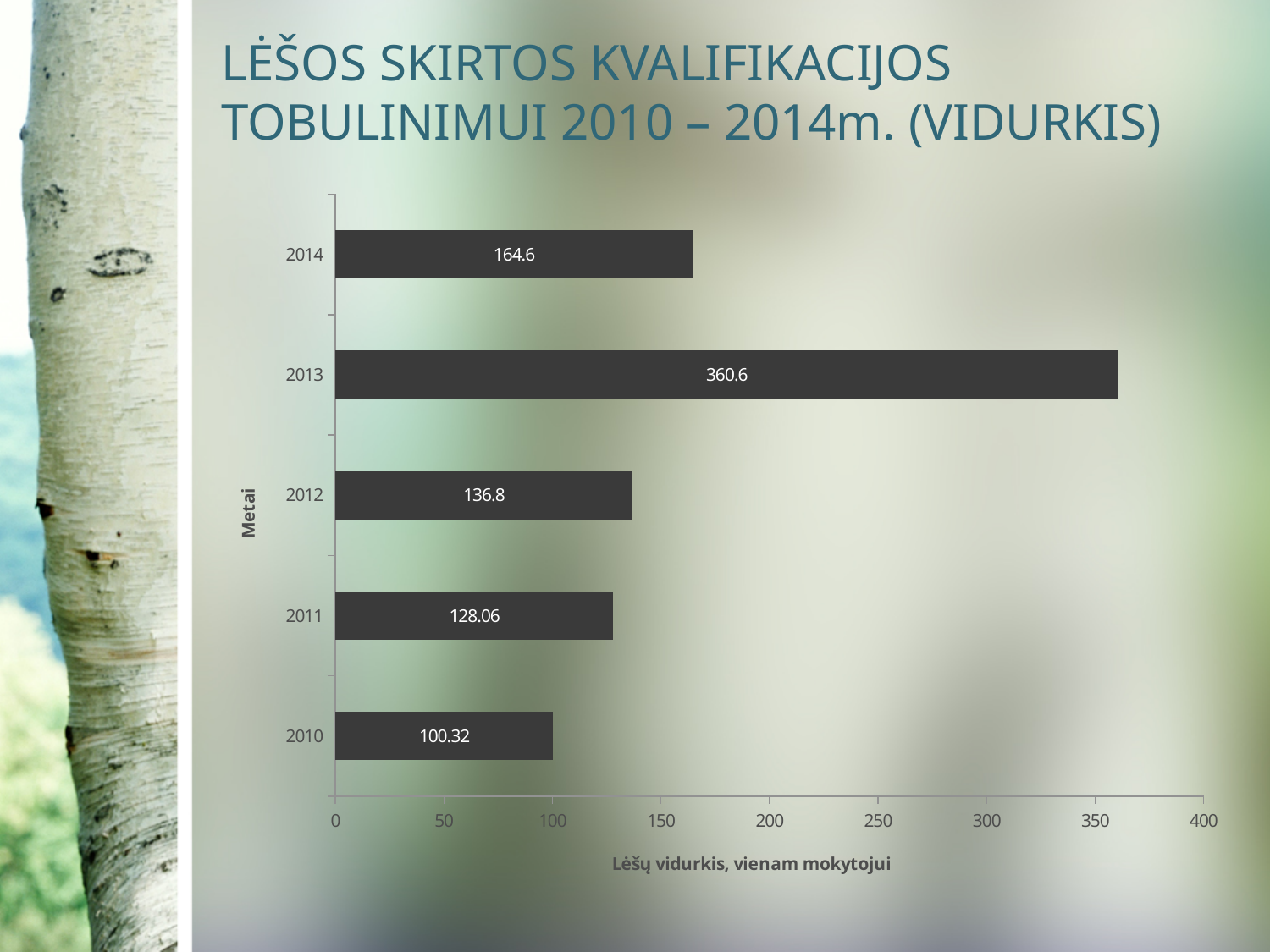
Which year has the lowest value? 2010 What is the difference between the values for 2013 and 2014? 196 What is the value for 2014? 164.6 What kind of chart is shown on the slide? bar chart Which year has the highest value? 2013 Is the value for 2013 greater or less than 350? greater What is the value for 2011? 128.06 What is the value for 2010? 100.32 What is the value for 2013? 360.6 Which is larger, the value for 2012 or the value for 2011? 2012 How many years are shown in the chart? 5 What is the label of the horizontal axis? Lėšų vidurkis, vienam mokytojui